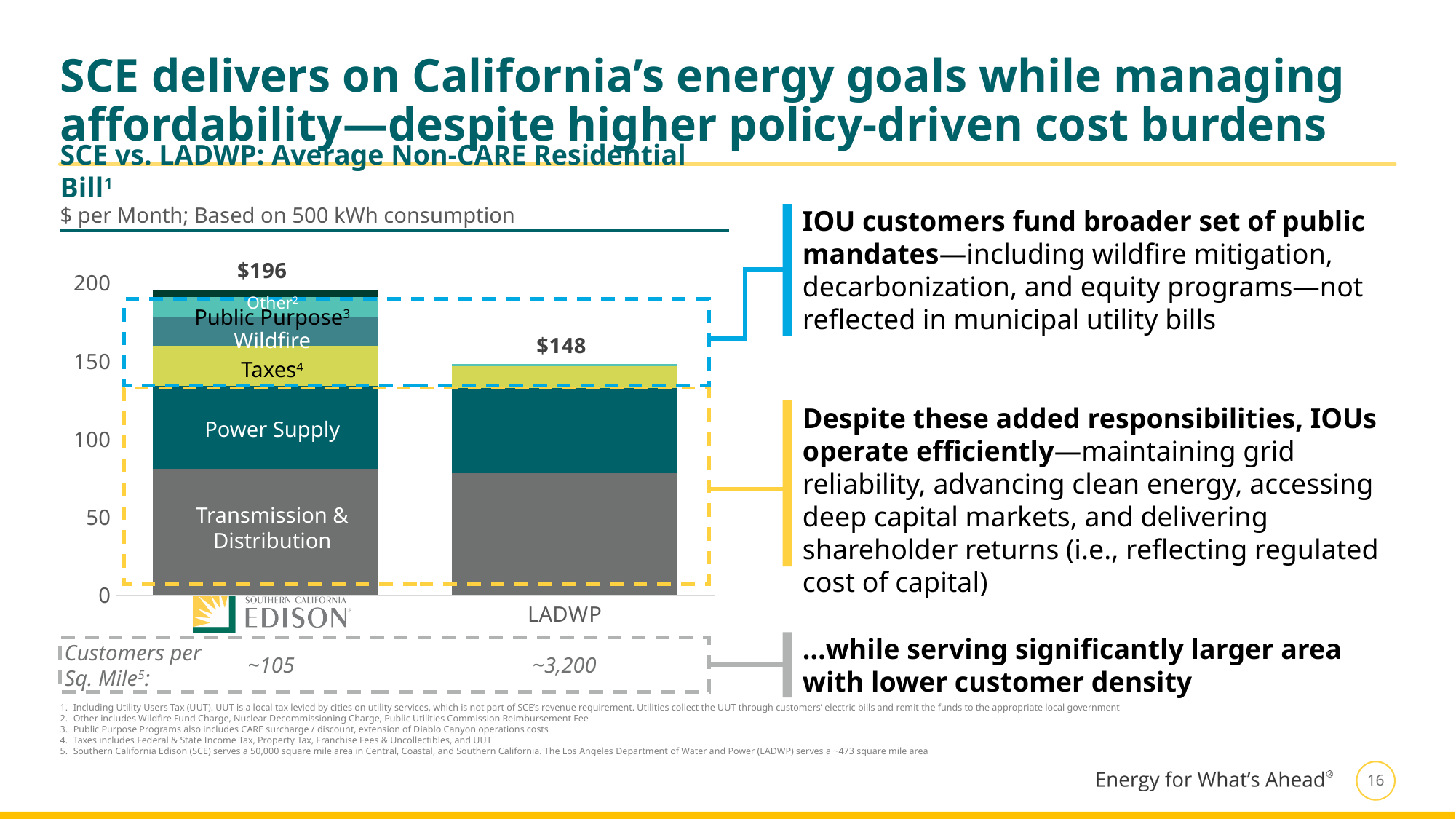
Which utility has the higher total monthly bill in the chart? Southern California Edison What is the average non-CARE residential bill shown for LADWP? $148 Is the Transmission & Distribution segment for Southern California Edison greater or less than 100? less Which cost component forms the bottom segment of each bar? Transmission & Distribution Is the total bill for LADWP greater or less than 150? less Which utility has the higher number of customers per square mile? LADWP Which utility has the lower total monthly bill in the chart? LADWP How many utilities (bars) are compared in the chart? 2 What is the difference between the SCE total bill and the LADWP total bill? $48 What is the average non-CARE residential bill shown for Southern California Edison? $196 What kind of chart is used to compare the SCE and LADWP bills? Stacked bar chart What unit and consumption basis does the chart subtitle state? $ per Month; Based on 500 kWh consumption